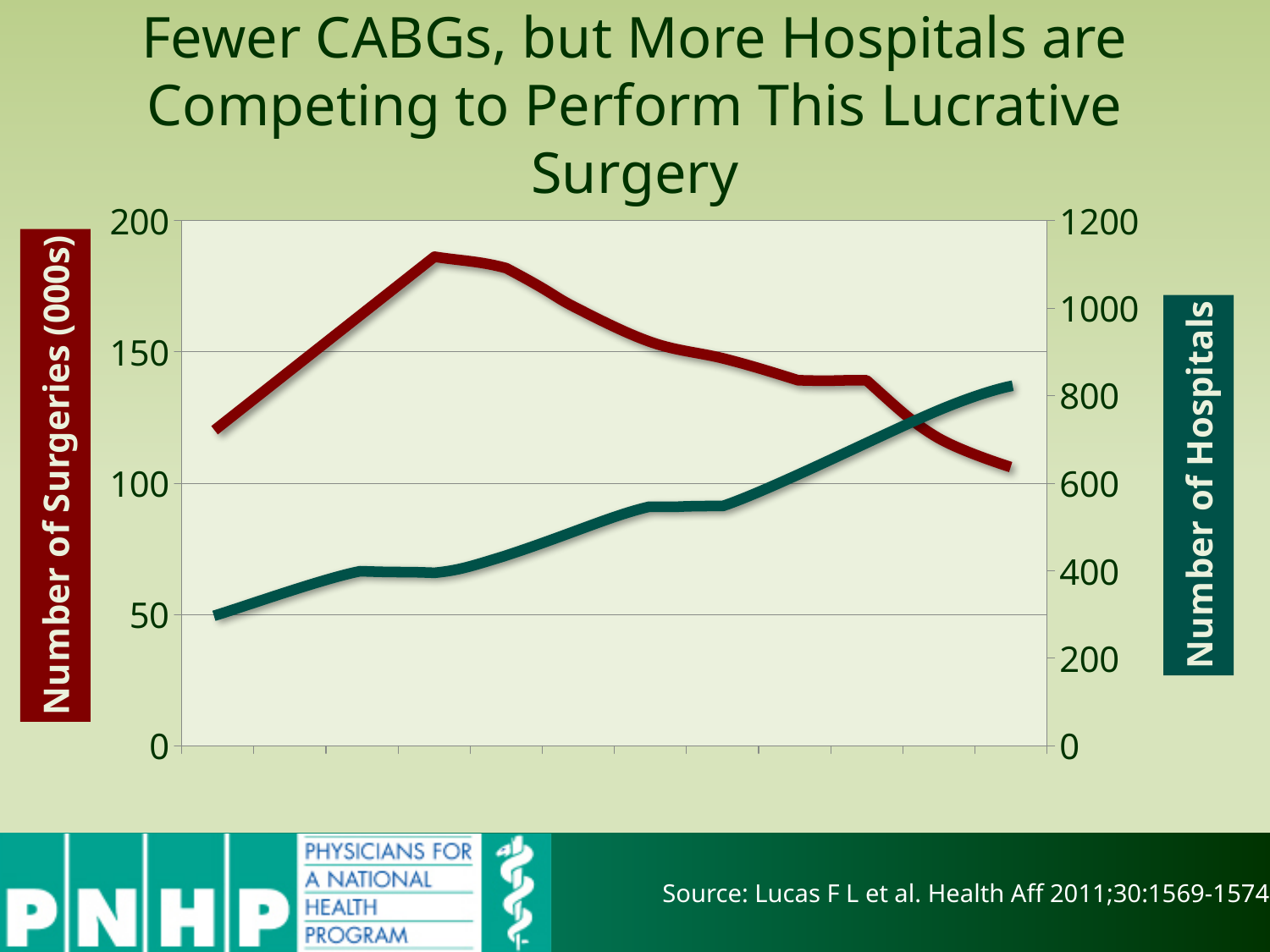
What is the maximum value shown on the right vertical axis? 1200 Is the highest value of the Number of Hospitals line greater or less than 1000? less What is the title of the left vertical axis? Number of Surgeries (000s) Does the Number of Hospitals line generally rise or fall from left to right? rise Does the Number of Surgeries line rise or fall over the right-hand half of the chart? fall What is the title of the right vertical axis? Number of Hospitals Is the first value of the Number of Hospitals line greater or less than 400? less Is the highest value of the Number of Surgeries line greater or less than 150? greater What kind of chart is shown on the slide? line chart How many data series are plotted on the chart? 2